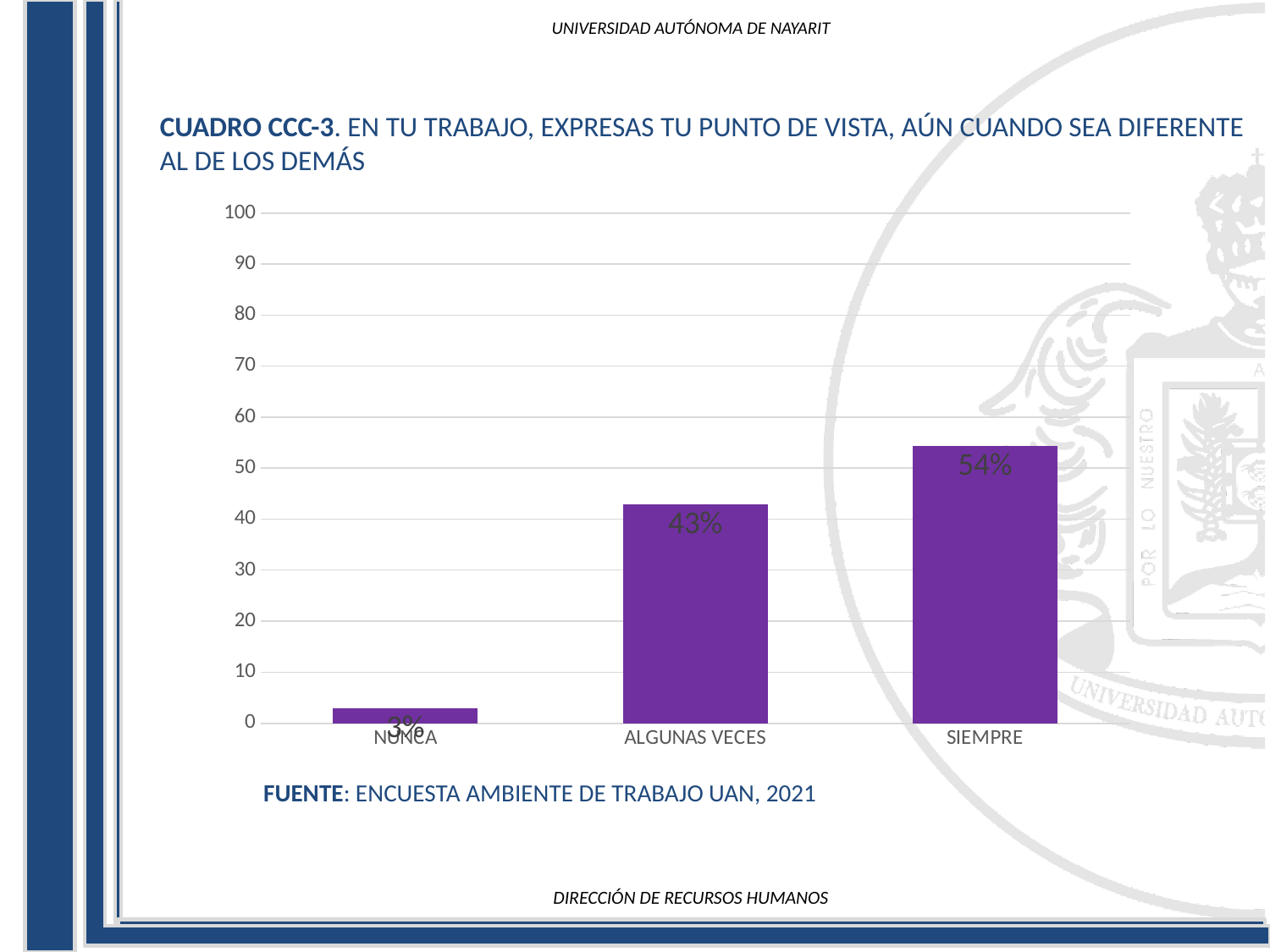
What is the value for NUNCA? 3% What kind of chart is shown on the slide? bar chart What is the value for ALGUNAS VECES? 43% Do the values rise or fall from NUNCA to SIEMPRE along the x axis? rise Which category has the lowest value? NUNCA Which category has the highest value? SIEMPRE Is the value for SIEMPRE greater or less than 50? greater Which is larger, the value for ALGUNAS VECES or the value for SIEMPRE? SIEMPRE What is the difference between the values for ALGUNAS VECES and NUNCA? 40% How many categories are shown on the x axis? 3 What is the difference between the values for SIEMPRE and ALGUNAS VECES? 11% What is the value for SIEMPRE? 54%